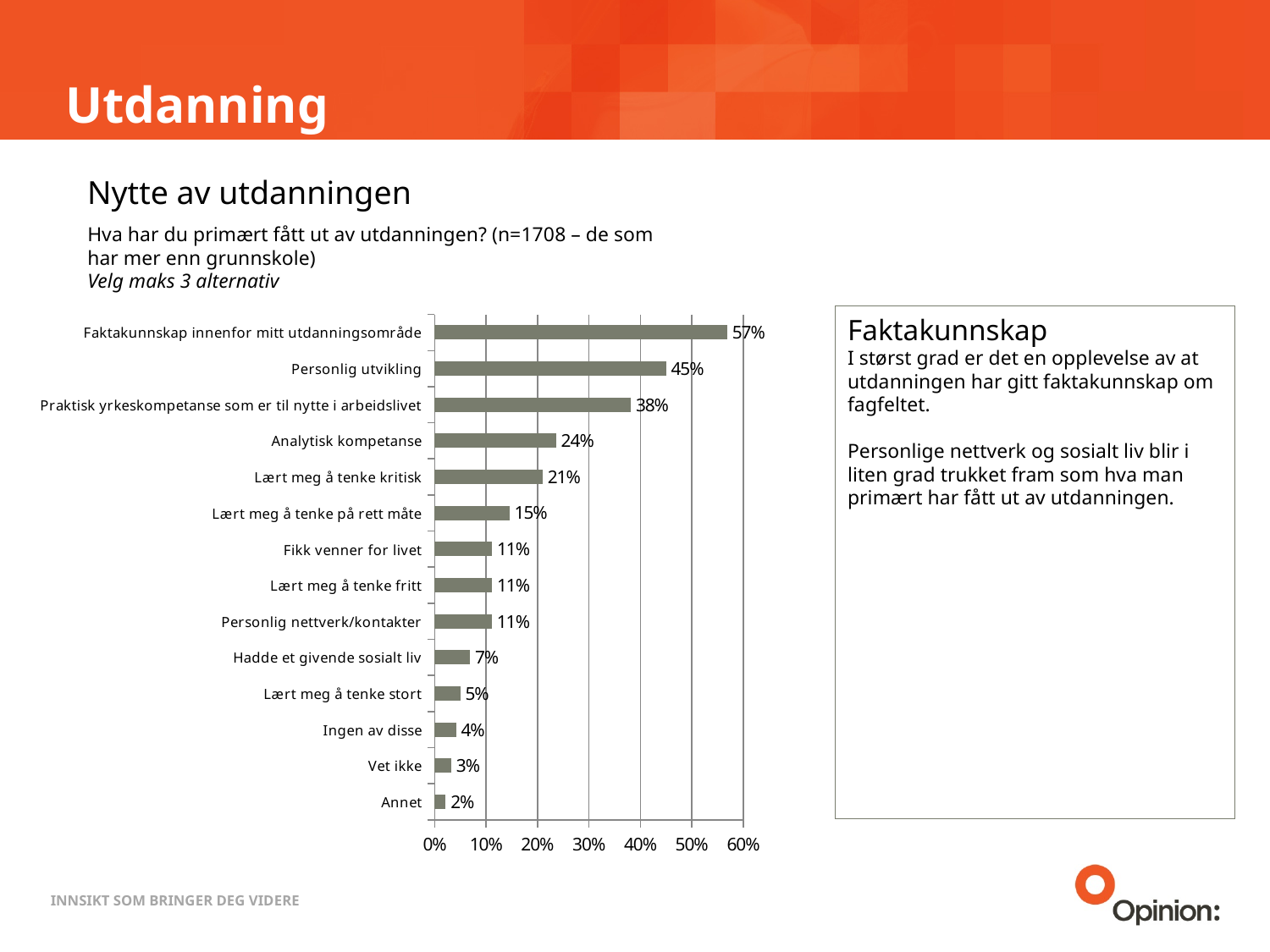
Which category has the highest value? Faktakunnskap innenfor mitt utdanningsområde What kind of chart is shown on the slide? Bar chart Which category has the lowest value? Annet What is the difference between "Praktisk yrkeskompetanse som er til nytte i arbeidslivet" and "Lært meg å tenke kritisk"? 17% What is the value for "Vet ikke"? 3% What is the difference between "Faktakunnskap innenfor mitt utdanningsområde" and "Personlig utvikling"? 12% How many categories are shown in the chart? 14 Which is larger, "Lært meg å tenke på rett måte" or "Hadde et givende sosialt liv"? Lært meg å tenke på rett måte What is the maximum value shown on the x axis? 60% What is the value for "Analytisk kompetanse"? 24% What is the value for "Personlig utvikling"? 45% Is the value for "Praktisk yrkeskompetanse som er til nytte i arbeidslivet" greater or less than 30%? greater